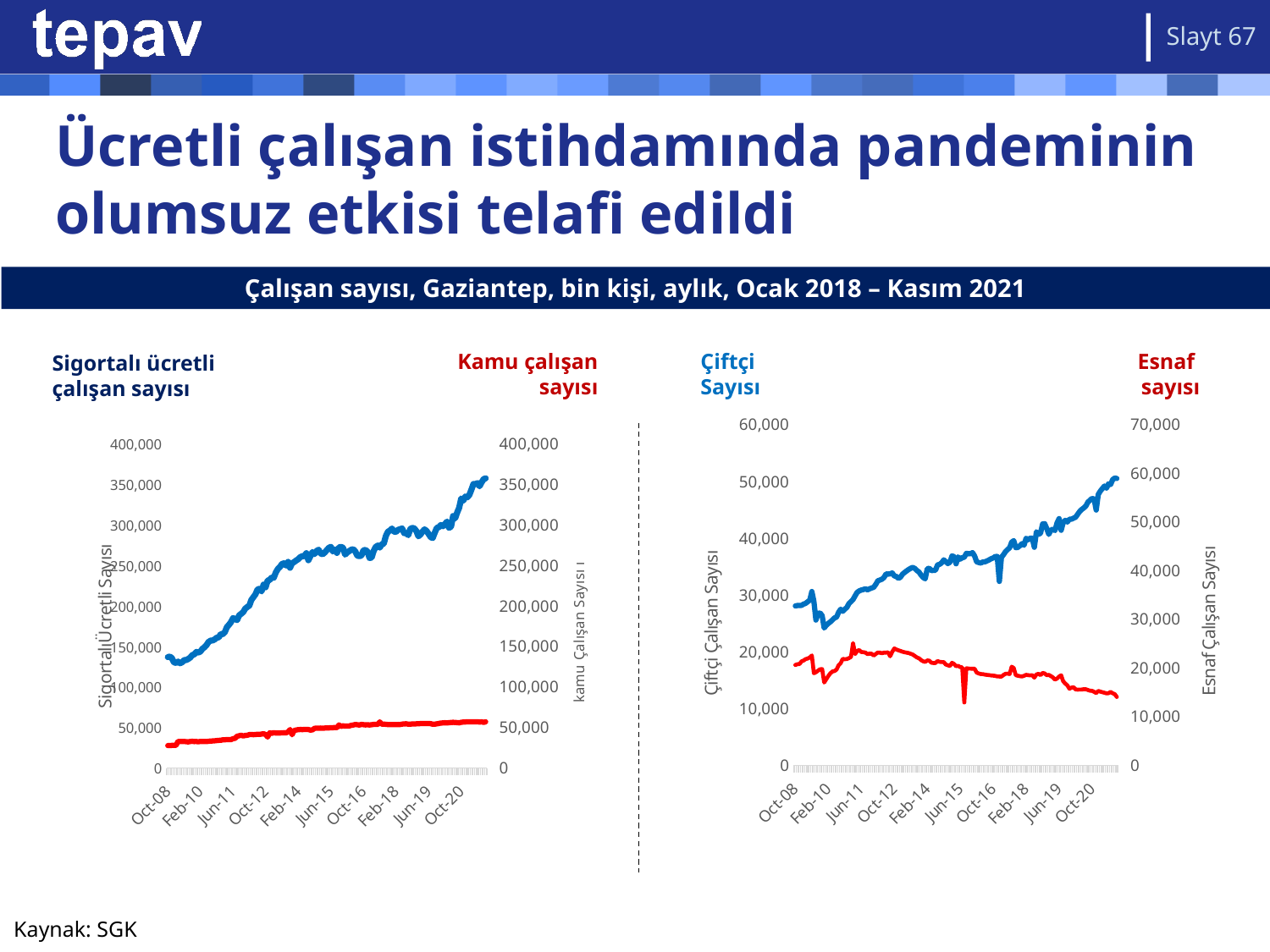
What type of chart is the right chart (Çiftçi Sayısı / Esnaf sayısı)? Line chart In the left chart, does the red Kamu çalışan sayısı line rise or fall over the period shown? Rise In the left chart, is the final value of the red Kamu çalışan sayısı line greater or less than 100,000? less How many series are plotted in the left chart? 2 In the left chart, is the final value of the blue Sigortalı ücretli çalışan sayısı line greater or less than 300,000? greater What is the title shown above the two charts? Çalışan sayısı, Gaziantep, bin kişi, aylık, Ocak 2018 – Kasım 2021 What type of chart is the left chart (Sigortalı ücretli çalışan sayısı / Kamu çalışan sayısı)? Line chart In the right chart, does the blue Çiftçi Sayısı line rise or fall from Oct-08 to the end of the period? Rise In the left chart, does the blue Sigortalı ücretli çalışan sayısı line rise or fall from Oct-08 to the end of the period? Rise In the right chart, is the final value of the red Esnaf sayısı line greater or less than 20,000 on the right-hand axis? less